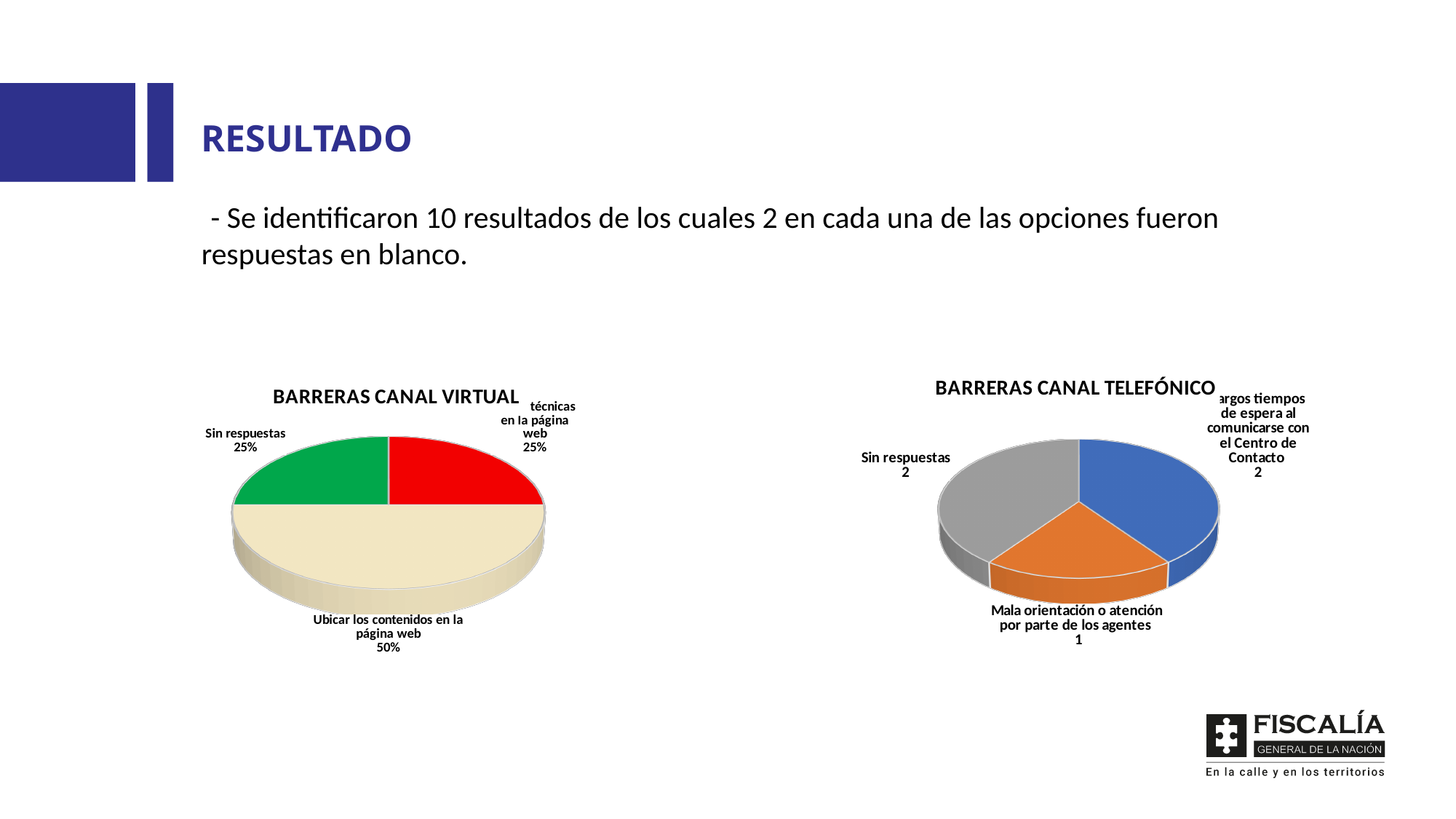
In the BARRERAS CANAL TELEFÓNICO chart, which category has the smallest value? Mala orientación o atención por parte de los agentes In the BARRERAS CANAL TELEFÓNICO chart, what value is shown for 'Sin respuestas'? 2 In the BARRERAS CANAL TELEFÓNICO chart, what value is shown for 'Mala orientación o atención por parte de los agentes'? 1 In the BARRERAS CANAL VIRTUAL chart, which category has the largest slice? Ubicar los contenidos en la página web In the BARRERAS CANAL VIRTUAL chart, what percentage is shown for 'Sin respuestas'? 25% In the BARRERAS CANAL TELEFÓNICO chart, which is larger: 'Sin respuestas' or 'Mala orientación o atención por parte de los agentes'? Sin respuestas In the BARRERAS CANAL VIRTUAL chart, what is the difference in percentage points between 'Ubicar los contenidos en la página web' and 'Sin respuestas'? 25 In the BARRERAS CANAL VIRTUAL chart, what percentage is shown for 'Ubicar los contenidos en la página web'? 50% How many slices does the BARRERAS CANAL VIRTUAL pie chart have? 3 In the BARRERAS CANAL TELEFÓNICO chart, what share of the total does 'Mala orientación o atención por parte de los agentes' represent? 20% In the BARRERAS CANAL TELEFÓNICO chart, what colour is the 'Sin respuestas' slice? Grey What type of chart is BARRERAS CANAL VIRTUAL? Pie chart